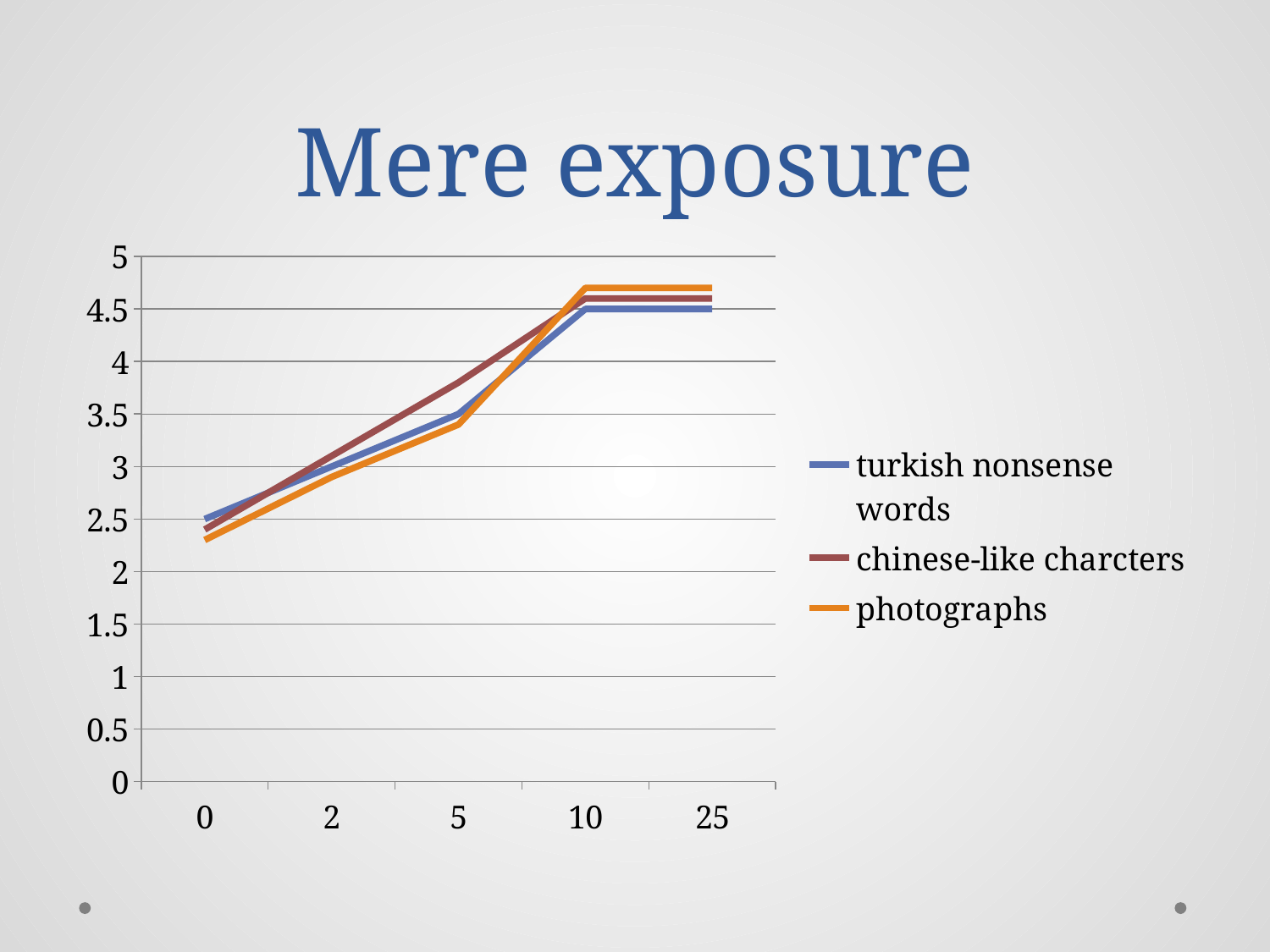
Do the values for photographs rise or fall from 0 to 10 along the x axis? rise What is the title of the slide? Mere exposure What kind of chart is shown on the slide? line chart Is the value for photographs at 0 greater or less than 2.5? less At 0, which series has the higher value: turkish nonsense words or photographs? turkish nonsense words How many points are marked along the x axis? 5 Is the value for photographs at 10 greater or less than 4.5? greater At 5, which series has the highest value? chinese-like charcters Is the value for turkish nonsense words at 2 greater or less than 2.5? greater At 5, which series has the higher value: chinese-like charcters or photographs? chinese-like charcters How many series does the legend list? 3